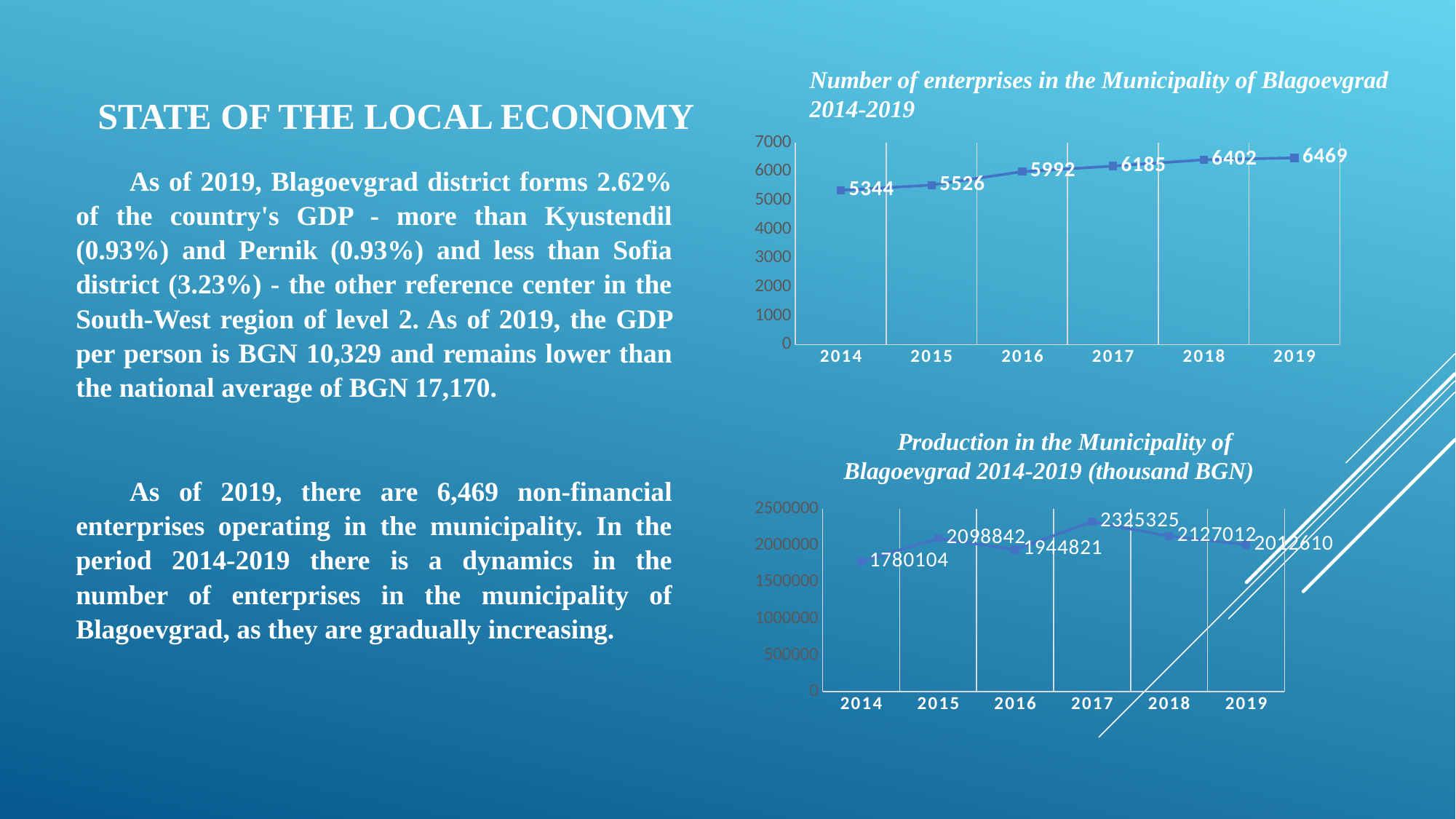
In the 'Production in the Municipality of Blagoevgrad 2014-2019 (thousand BGN)' chart, is the value for 2017 greater or less than 2000000? greater In the 'Production in the Municipality of Blagoevgrad 2014-2019 (thousand BGN)' chart, what is the value for 2014? 1780104 What type of chart is the 'Number of enterprises in the Municipality of Blagoevgrad 2014-2019' chart? line chart In the 'Number of enterprises in the Municipality of Blagoevgrad 2014-2019' chart, do the values rise or fall from 2014 to 2019? rise In the 'Production in the Municipality of Blagoevgrad 2014-2019 (thousand BGN)' chart, what is the value for 2017? 2325325 In the 'Number of enterprises in the Municipality of Blagoevgrad 2014-2019' chart, what is the value for 2014? 5344 In the 'Number of enterprises in the Municipality of Blagoevgrad 2014-2019' chart, what is the value for 2016? 5992 In the 'Production in the Municipality of Blagoevgrad 2014-2019 (thousand BGN)' chart, which is larger, the value for 2015 or the value for 2016? 2015 In the 'Number of enterprises in the Municipality of Blagoevgrad 2014-2019' chart, which year has the highest value? 2019 In the 'Number of enterprises in the Municipality of Blagoevgrad 2014-2019' chart, what is the difference between the 2019 and 2014 values? 1125 In the 'Production in the Municipality of Blagoevgrad 2014-2019 (thousand BGN)' chart, which year has the lowest value? 2014 How many years are plotted in the 'Production in the Municipality of Blagoevgrad 2014-2019 (thousand BGN)' chart? 6